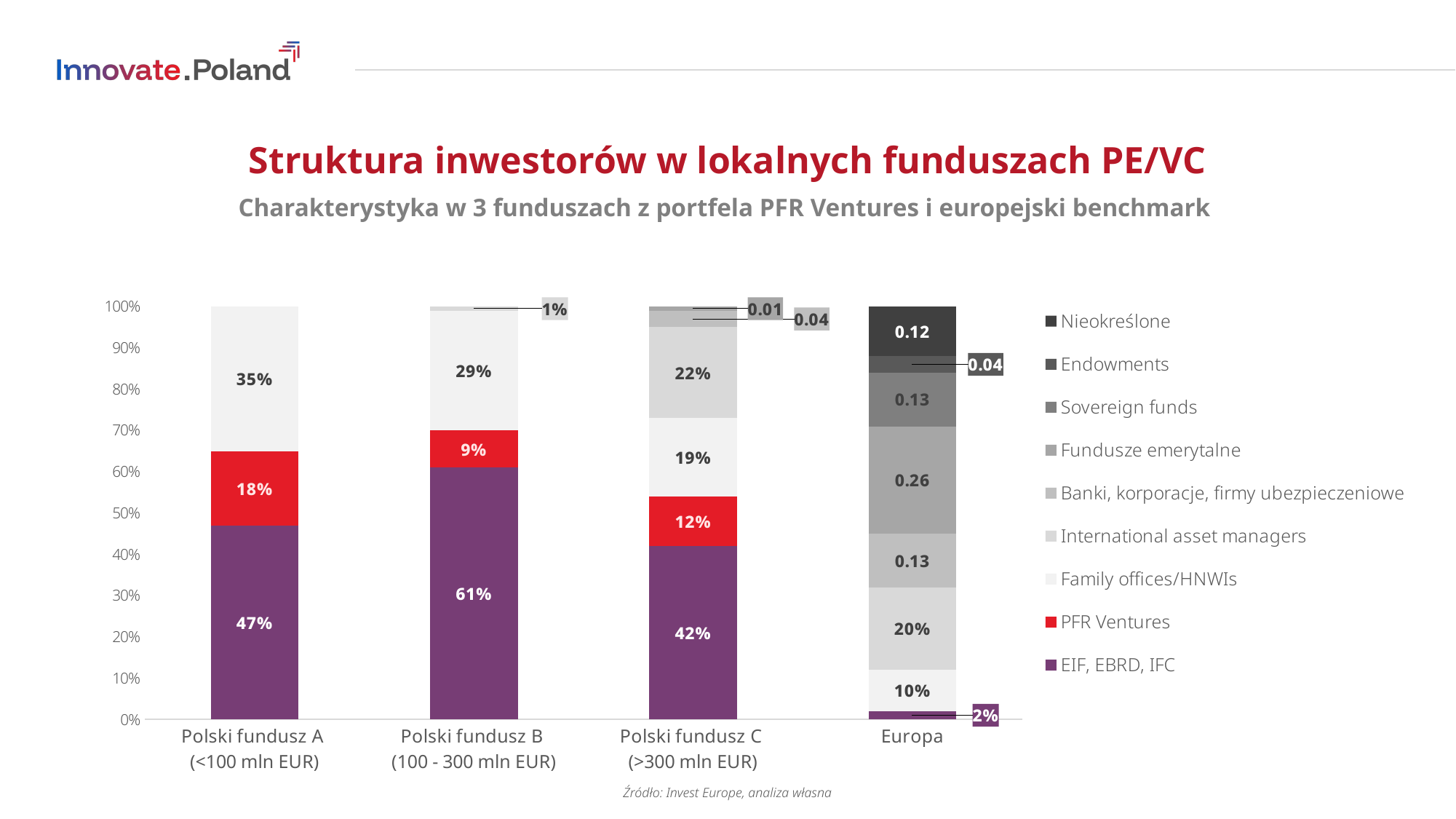
How many categories (bars) are shown on the x axis? 4 What is the share of Family offices/HNWIs in Polski fundusz C (>300 mln EUR)? 19% What kind of chart is shown on the slide? Stacked bar chart What value is shown for Fundusze emerytalne in the Europa bar? 0.26 By how many percentage points does the PFR Ventures share in Polski fundusz A exceed that in Polski fundusz B? 9 percentage points Which category has the lowest share of EIF, EBRD, IFC? Europa Which category has the highest share of EIF, EBRD, IFC? Polski fundusz B (100 - 300 mln EUR) What is the share of PFR Ventures in Polski fundusz A (<100 mln EUR)? 18% Which has a larger Family offices/HNWIs share, Polski fundusz A or Polski fundusz B? Polski fundusz A What is the share of EIF, EBRD, IFC in Polski fundusz B (100 - 300 mln EUR)? 61% How many series does the legend list? 9 What is the share of International asset managers in the Europa bar? 20%